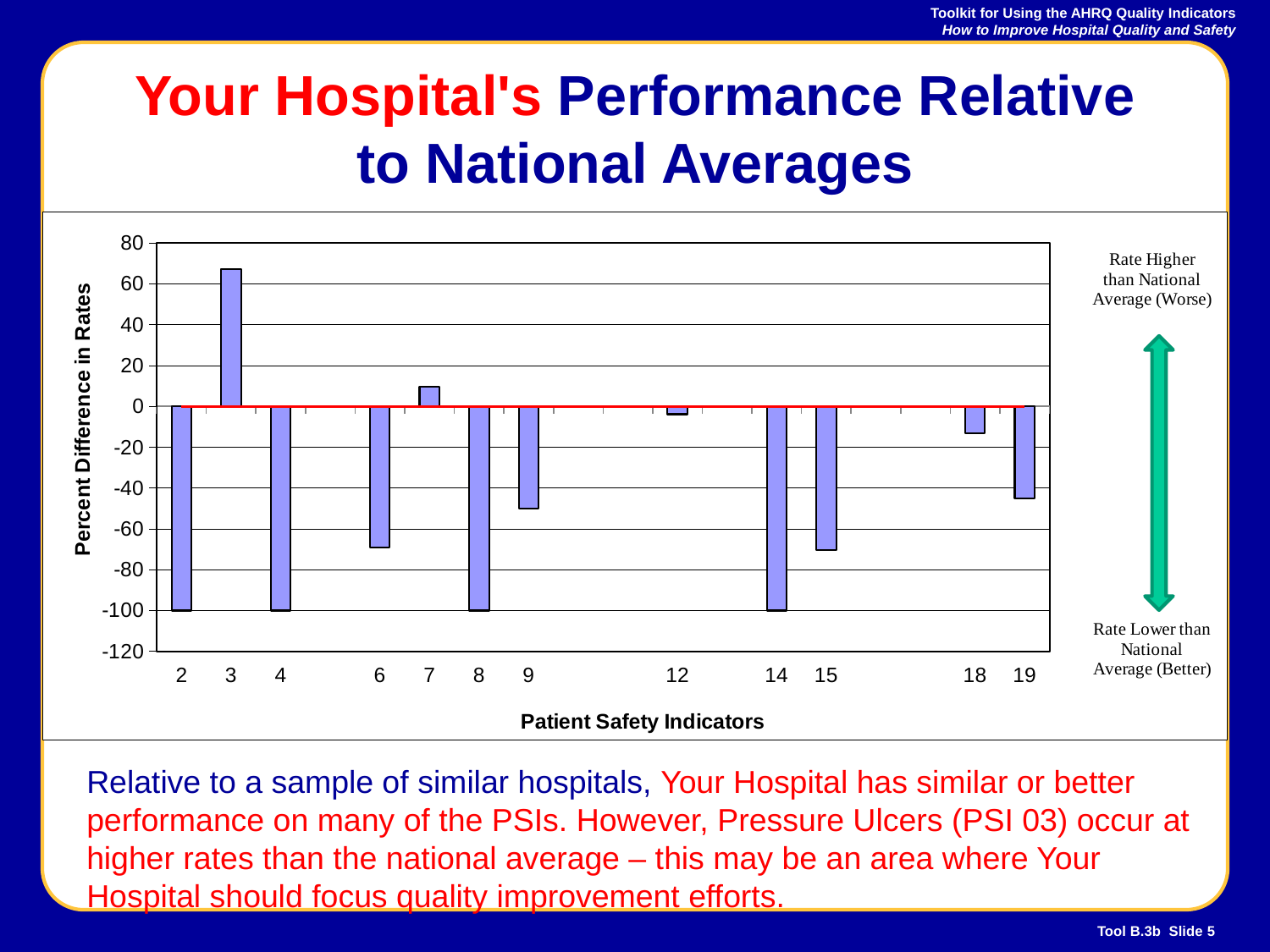
How many Patient Safety Indicators are plotted on the x axis? 12 Which Patient Safety Indicator has the highest percent difference in rates? 3 How many Patient Safety Indicators have a positive percent difference in rates (bar above zero)? 2 Is the value for Patient Safety Indicator 18 greater or less than -20? greater Is the value for Patient Safety Indicator 15 greater or less than -60? less What kind of chart is shown on the slide? bar chart Which has the larger percent difference in rates, Patient Safety Indicator 3 or Patient Safety Indicator 7? 3 Which has the lower percent difference in rates, Patient Safety Indicator 6 or Patient Safety Indicator 18? 6 What is the title of the y axis? Percent Difference in Rates Is the value for Patient Safety Indicator 7 greater or less than 20? less